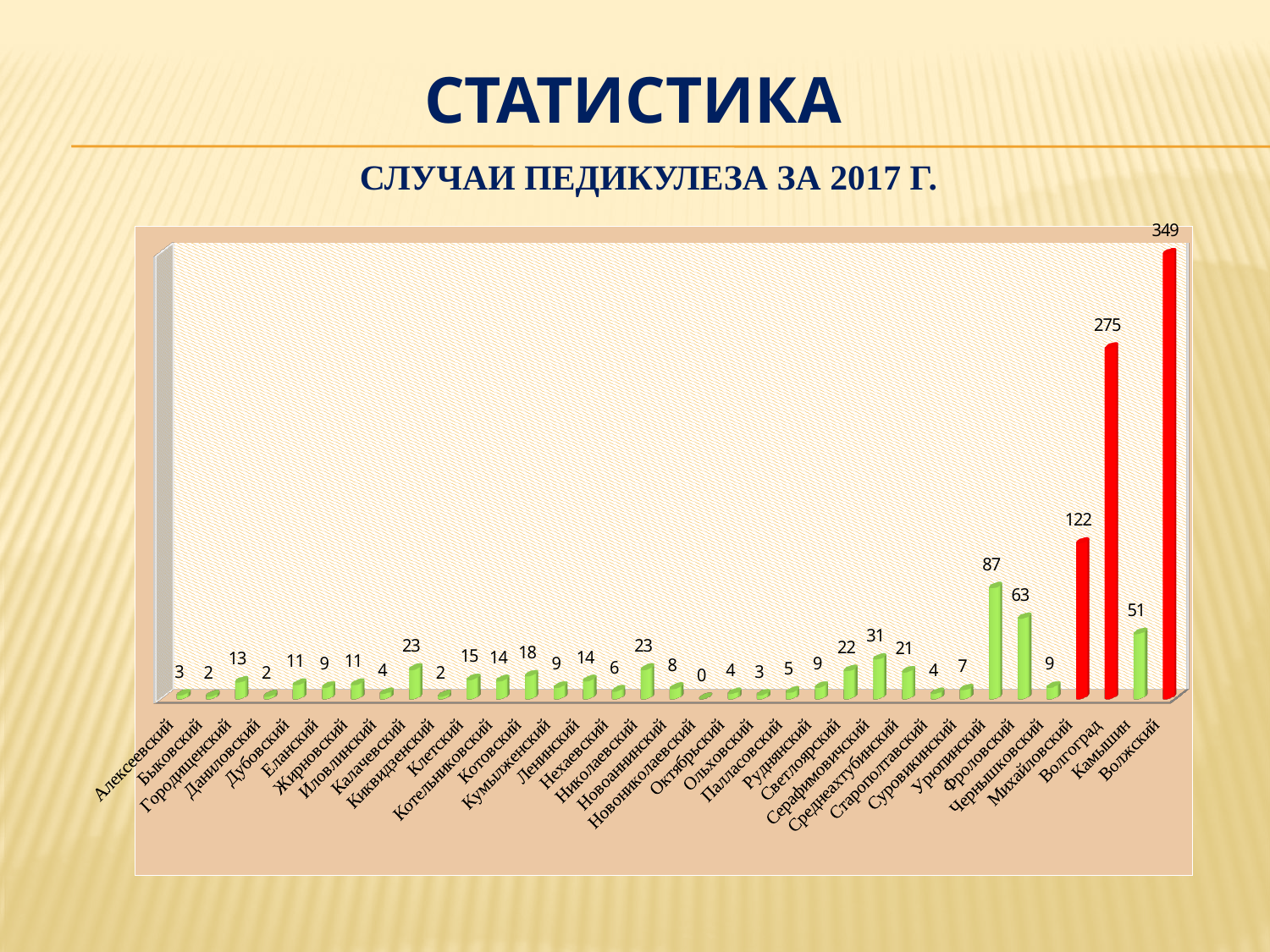
What is the difference between the values for Михайловский and Камышин? 71 What is the value for Серафимовичский? 31 What is the value for Урюпинский? 87 What is the difference between the values for Волжский and Волгоград? 74 Which is larger, the value for Калачевский or the value for Клетский? Калачевский Which category has the lowest value? Новониколаевский What is the value for Волжский? 349 How many categories are shown on the x axis? 35 Which is larger, the value for Урюпинский or the value for Фроловский? Урюпинский What kind of chart is shown on the slide? bar chart What is the subtitle above the chart? СЛУЧАИ ПЕДИКУЛЕЗА ЗА 2017 Г. Which category has the highest value? Волжский